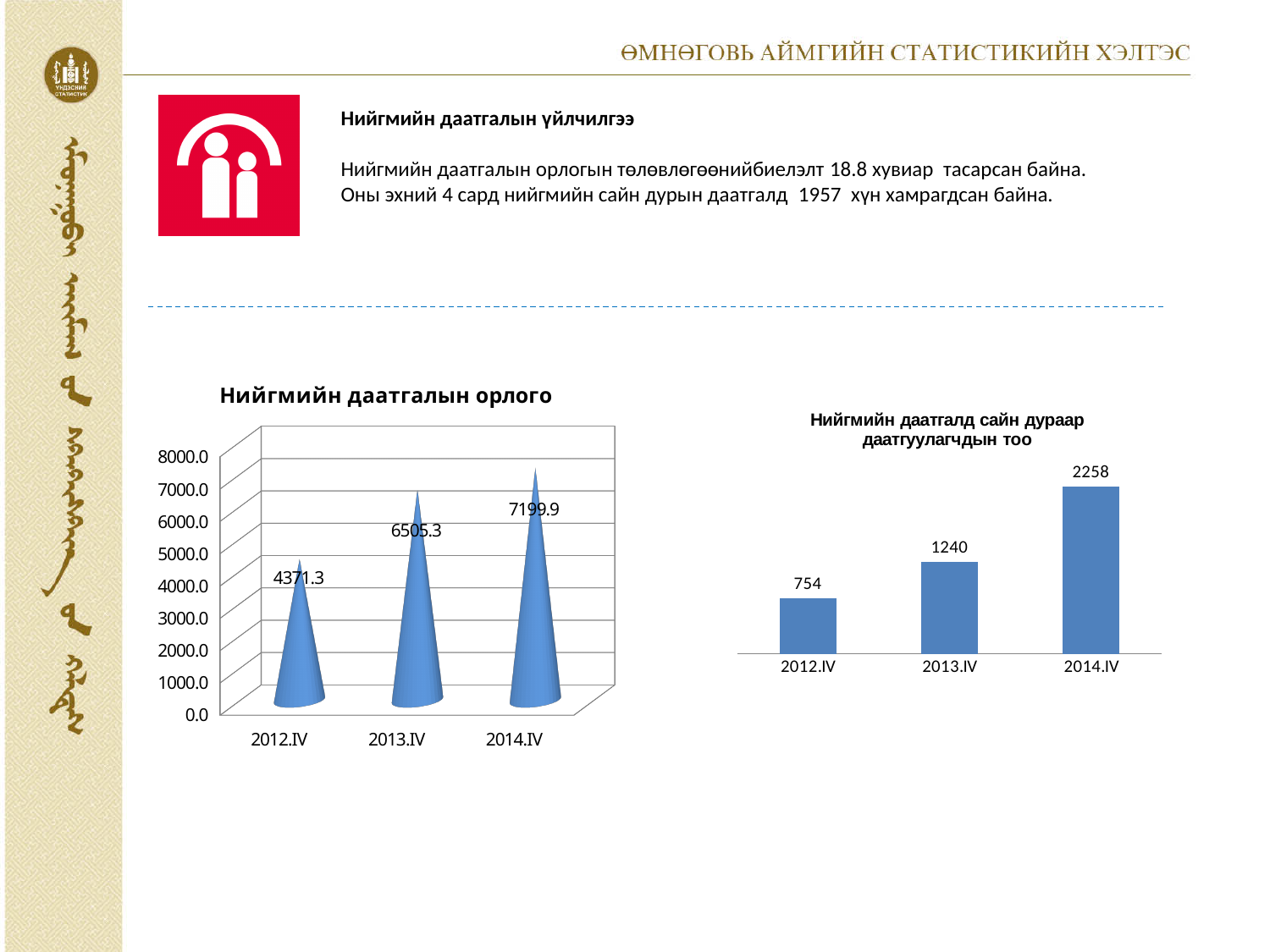
In the chart titled 'Нийгмийн даатгалын орлого', what is the difference between the values for 2014.IV and 2013.IV? 694.6 What kind of chart is the one titled 'Нийгмийн даатгалд сайн дураар даатгуулагчдын тоо'? bar chart In the chart titled 'Нийгмийн даатгалын орлого', do the values rise or fall from 2012.IV to 2014.IV? rise In the chart titled 'Нийгмийн даатгалд сайн дураар даатгуулагчдын тоо', which period has the lowest value? 2012.IV In the chart titled 'Нийгмийн даатгалын орлого', what is the value for 2013.IV? 6505.3 In the chart titled 'Нийгмийн даатгалын орлого', which period has the highest value? 2014.IV In the chart titled 'Нийгмийн даатгалын орлого', what is the value for 2012.IV? 4371.3 In the chart titled 'Нийгмийн даатгалд сайн дураар даатгуулагчдын тоо', what is the difference between the values for 2014.IV and 2012.IV? 1504 In the chart titled 'Нийгмийн даатгалд сайн дураар даатгуулагчдын тоо', what is the value for 2014.IV? 2258 In the chart titled 'Нийгмийн даатгалын орлого', how many periods are plotted? 3 What is the title of the chart on the left side of the slide? Нийгмийн даатгалын орлого In the chart titled 'Нийгмийн даатгалд сайн дураар даатгуулагчдын тоо', which is larger, the value for 2013.IV or 2012.IV? 2013.IV